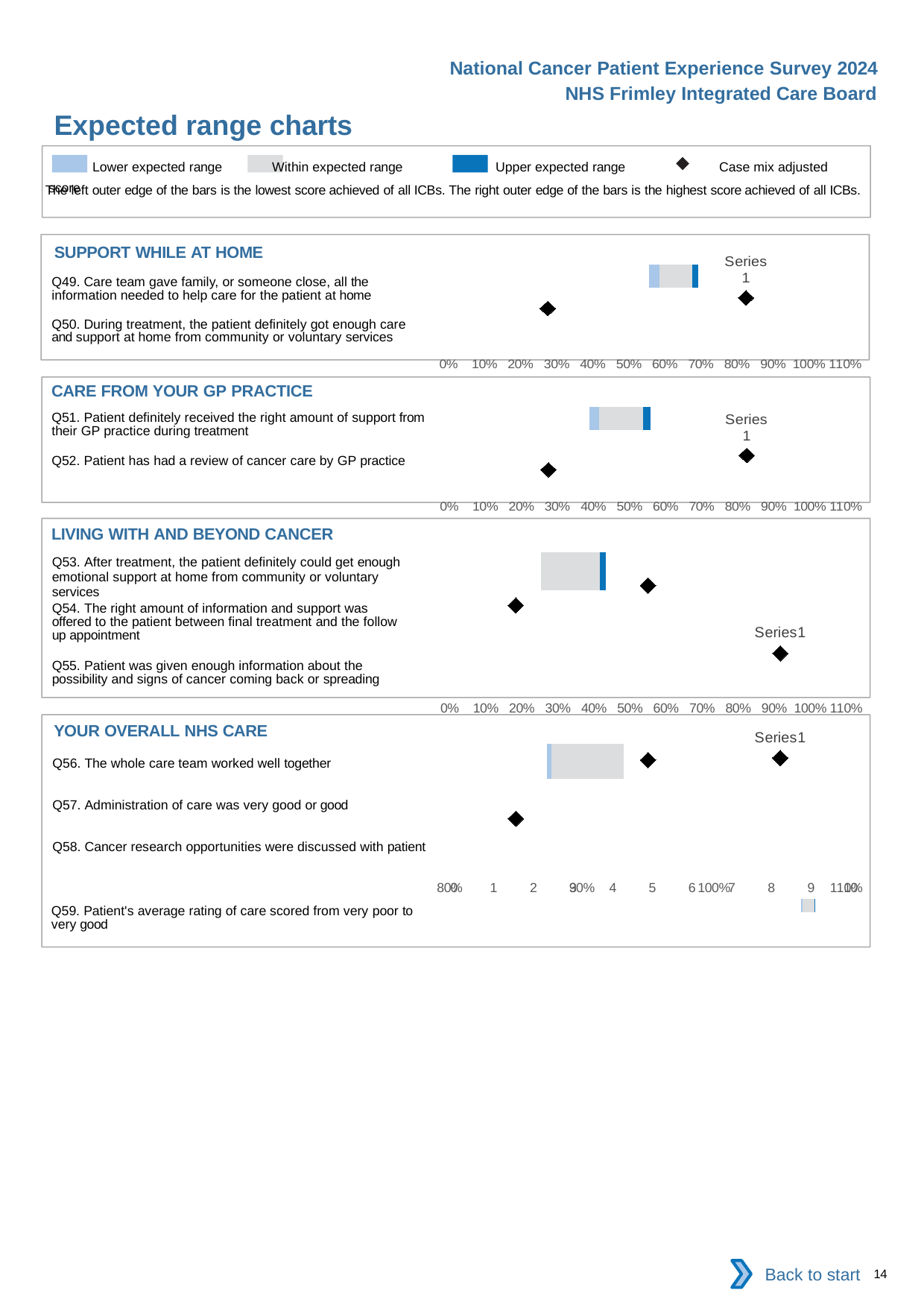
How many survey questions are listed in the Living with and beyond cancer section? 3 What is the highest tick label on the x axis of the Support while at home chart? 110% What is the interval between consecutive tick labels on the x axis of the Living with and beyond cancer chart? 10% Which legend entry is represented by a black diamond marker? Case mix adjusted score Which legend entry is shown in dark blue? Upper expected range How many entries does the legend at the top of the slide list? 4 How many survey questions are listed in the Support while at home section? 2 What is the lowest tick label on the x axis of the Care from your GP practice chart? 0% How many survey questions are listed in the Your overall NHS care section? 4